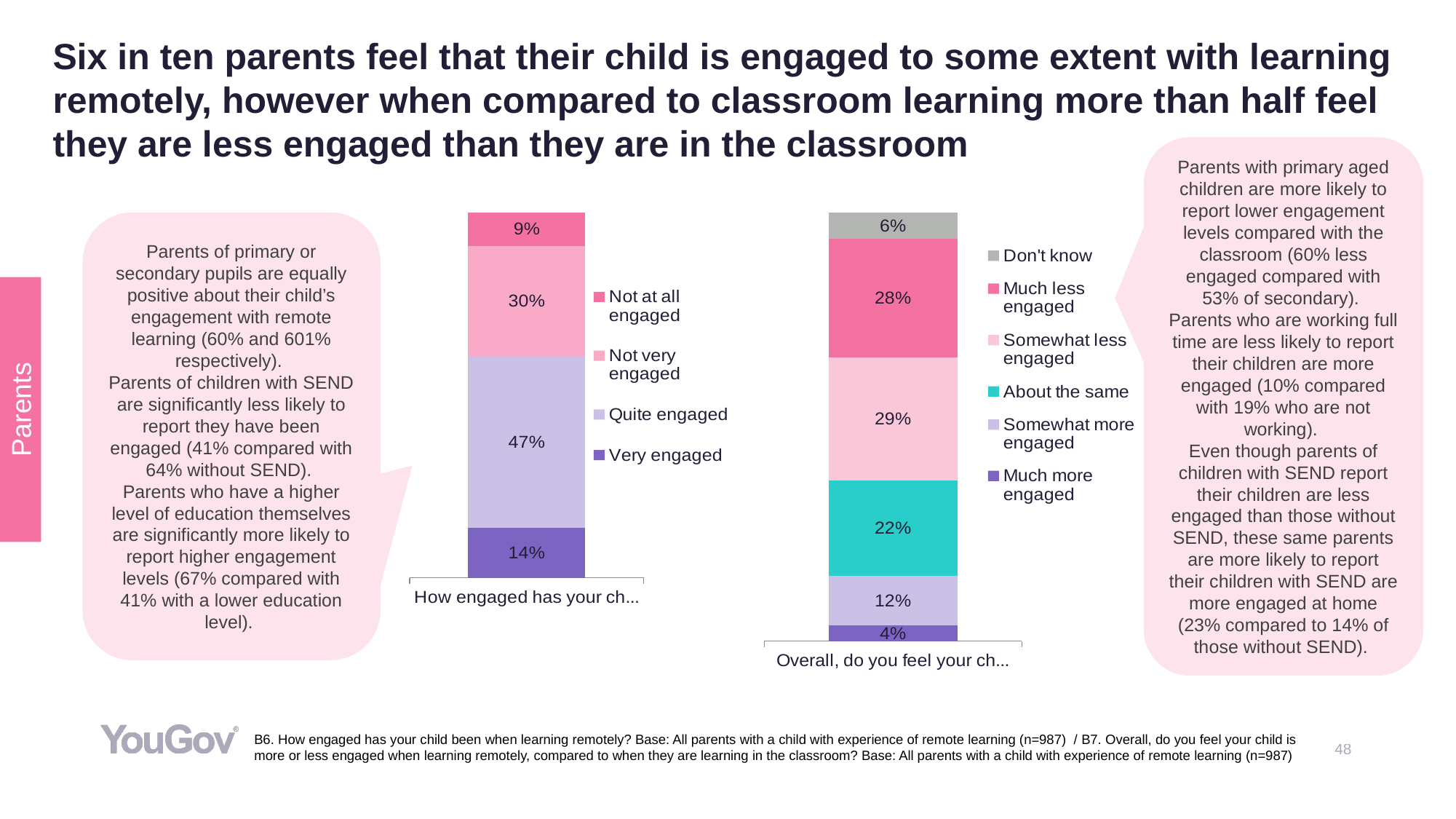
In the left chart (How engaged has your child been), how many series does the legend list? 4 What type of chart is used for the two charts on the slide? Stacked bar chart In the left chart (How engaged has your child been), what is the difference between 'Not very engaged' and 'Very engaged'? 16 percentage points In the right chart (Overall, do you feel your child is more or less engaged), what percentage said 'Much more engaged'? 4% In the right chart (Overall, do you feel your child is more or less engaged), how many series does the legend list? 6 In the right chart (Overall, do you feel your child is more or less engaged), which response has the smallest share? Much more engaged In the left chart (How engaged has your child been), which response has the largest share? Quite engaged In the left chart (How engaged has your child been), what percentage of parents said their child was 'Quite engaged'? 47% In the left chart (How engaged has your child been), what percentage of parents said their child was 'Not at all engaged'? 9% In the right chart (Overall, do you feel your child is more or less engaged), which is larger: 'Somewhat less engaged' or 'Somewhat more engaged'? Somewhat less engaged In the right chart (Overall, do you feel your child is more or less engaged), what percentage said 'About the same'? 22% In the right chart (Overall, do you feel your child is more or less engaged), what is the combined share of 'Much less engaged' and 'Somewhat less engaged'? 57%